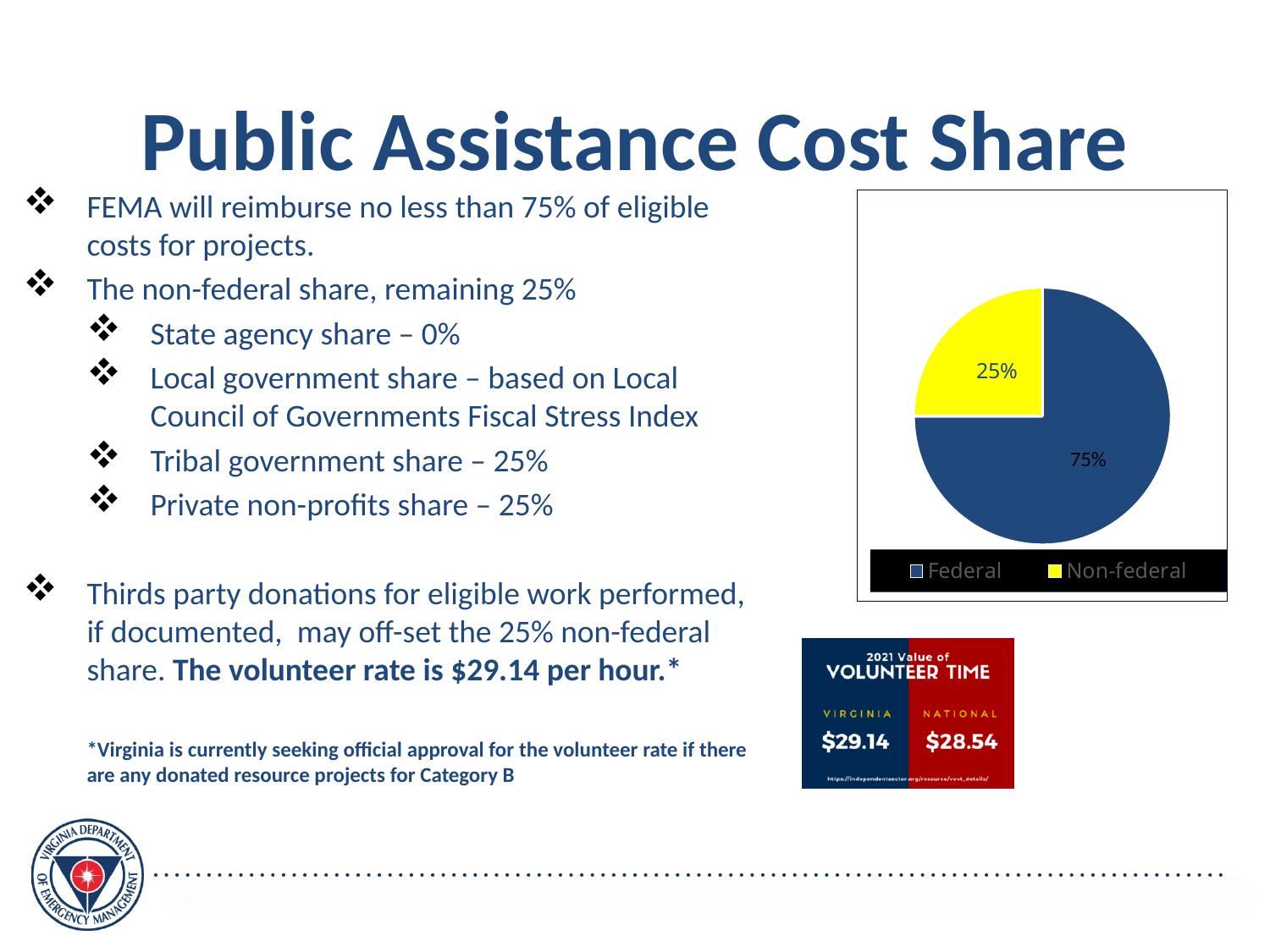
Which is larger in the pie chart, the Federal share or the Non-federal share? Federal Which slice of the pie chart is the largest? Federal What share of the pie chart is labelled Federal? 75% What colour is the Non-federal slice in the pie chart? yellow How many entries does the pie chart's legend list? 2 What is the difference between the Federal and Non-federal shares in the pie chart? 50% Which slice of the pie chart is the smallest? Non-federal What share of the pie chart is labelled Non-federal? 25% How many slices does the pie chart have? 2 What colour is the Federal slice in the pie chart? blue What kind of chart is shown on the slide? pie chart